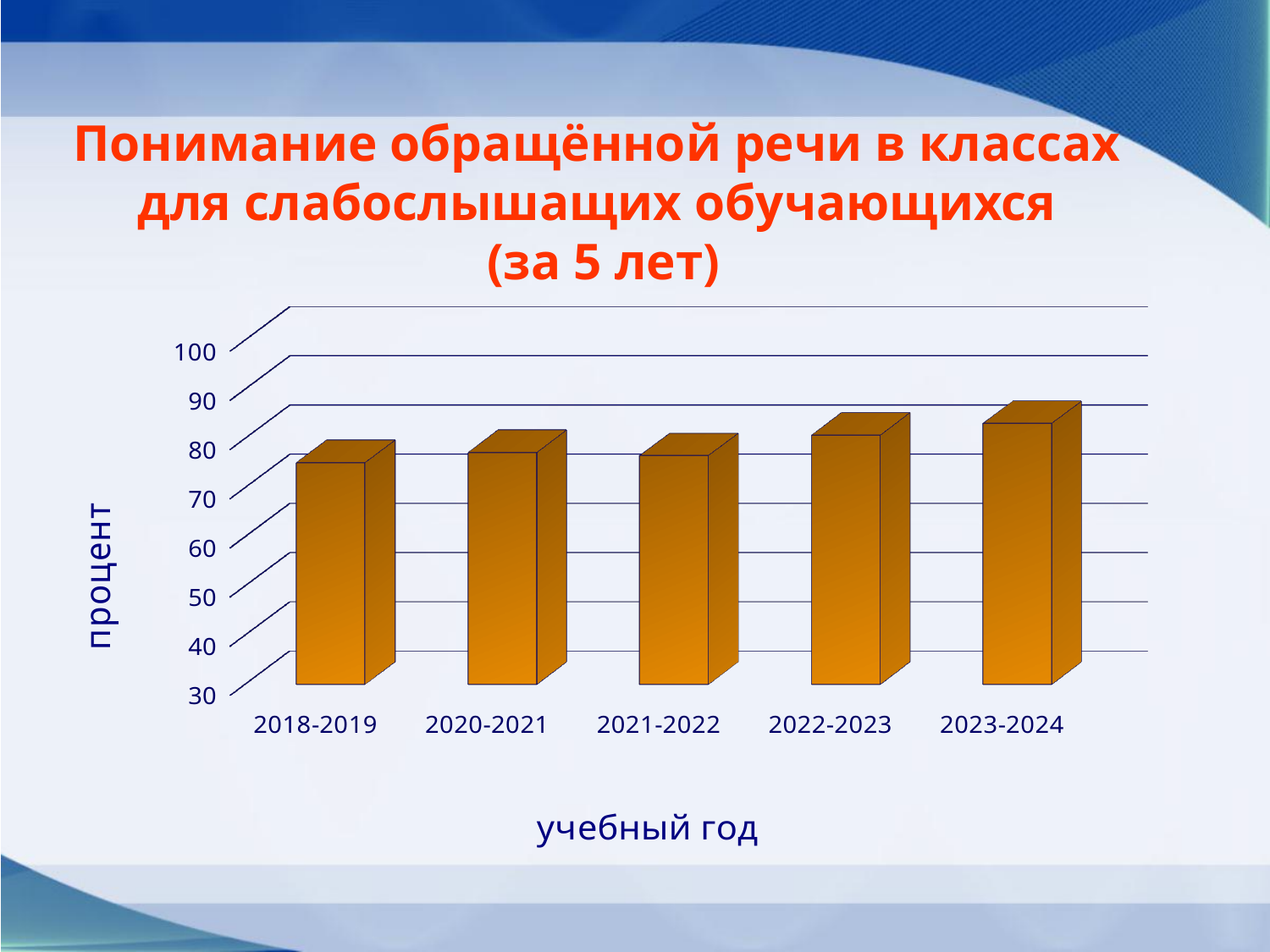
Is the value for 2018-2019 greater or less than 90? less What is the label of the vertical axis? процент Which is larger, the value for 2022-2023 or the value for 2020-2021? 2022-2023 Is the value for 2020-2021 greater or less than 70? greater How many academic years (categories) are shown on the x axis? 5 Which academic year has the highest value? 2023-2024 Which is larger, the value for 2023-2024 or the value for 2018-2019? 2023-2024 Do the values generally rise or fall from 2018-2019 to 2023-2024? rise What kind of chart is shown on the slide? bar chart Is the value for 2023-2024 greater or less than 80? greater What is the label of the horizontal axis? учебный год